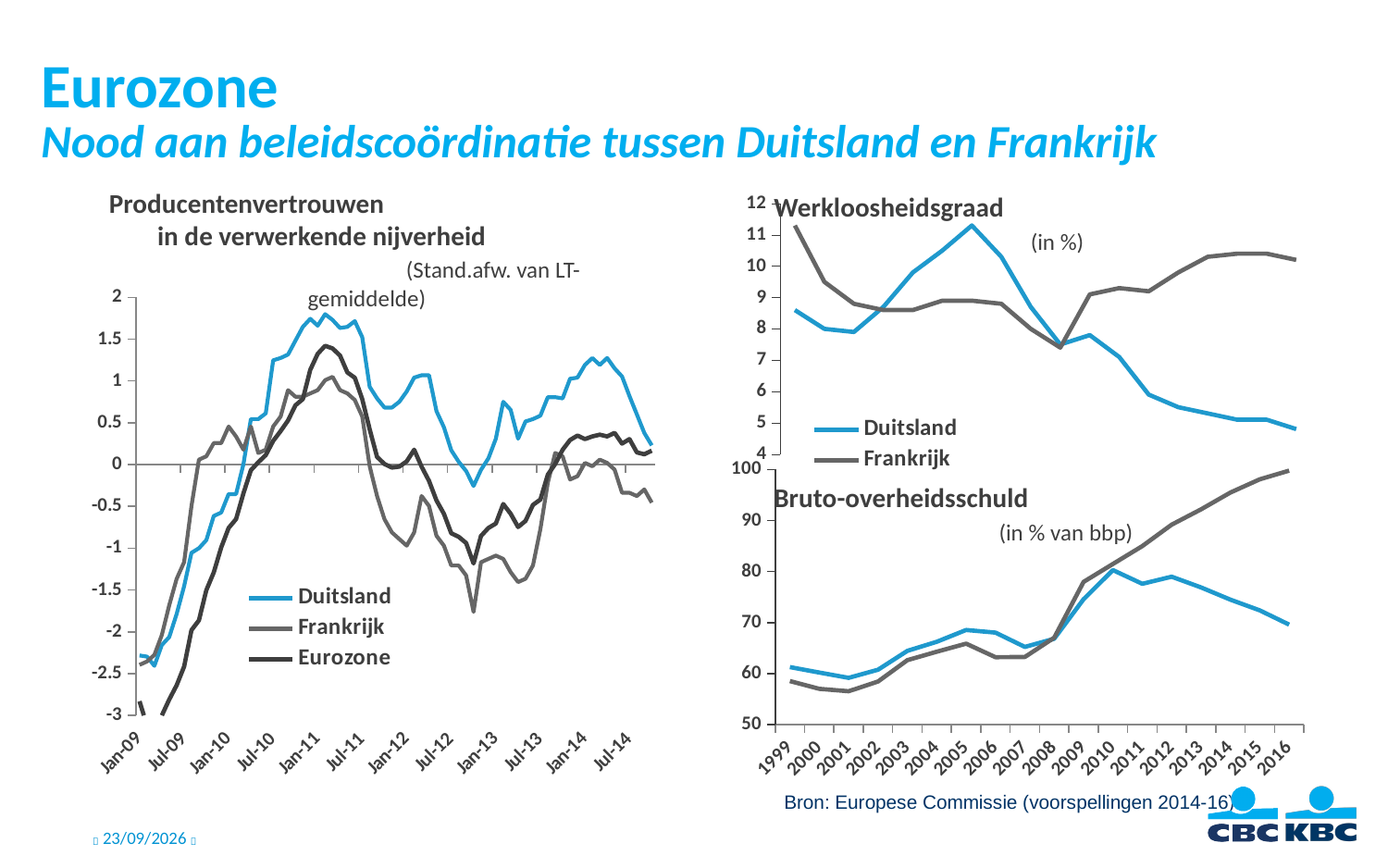
In the 'Bruto-overheidsschuld' chart, does the Frankrijk line rise or fall from 2008 to 2016? rise How many series does the legend of the 'Werkloosheidsgraad' chart list? 2 In the 'Werkloosheidsgraad' chart, is the value for Duitsland in 2005 greater or less than 11? greater What kind of chart is the 'Producentenvertrouwen in de verwerkende nijverheid' chart? line chart In the 'Bruto-overheidsschuld' chart, is the value for Frankrijk in 2016 greater or less than 90? greater In the 'Werkloosheidsgraad' chart, is the value for Duitsland in 2016 greater or less than 5? less How many series does the legend of the 'Producentenvertrouwen in de verwerkende nijverheid' chart list? 3 In the 'Werkloosheidsgraad' chart, which country has the higher unemployment rate in 2016, Duitsland or Frankrijk? Frankrijk In the 'Werkloosheidsgraad' chart, does the Duitsland line rise or fall from 2005 to 2016? fall What unit is shown under the title of the 'Bruto-overheidsschuld' chart? in % van bbp